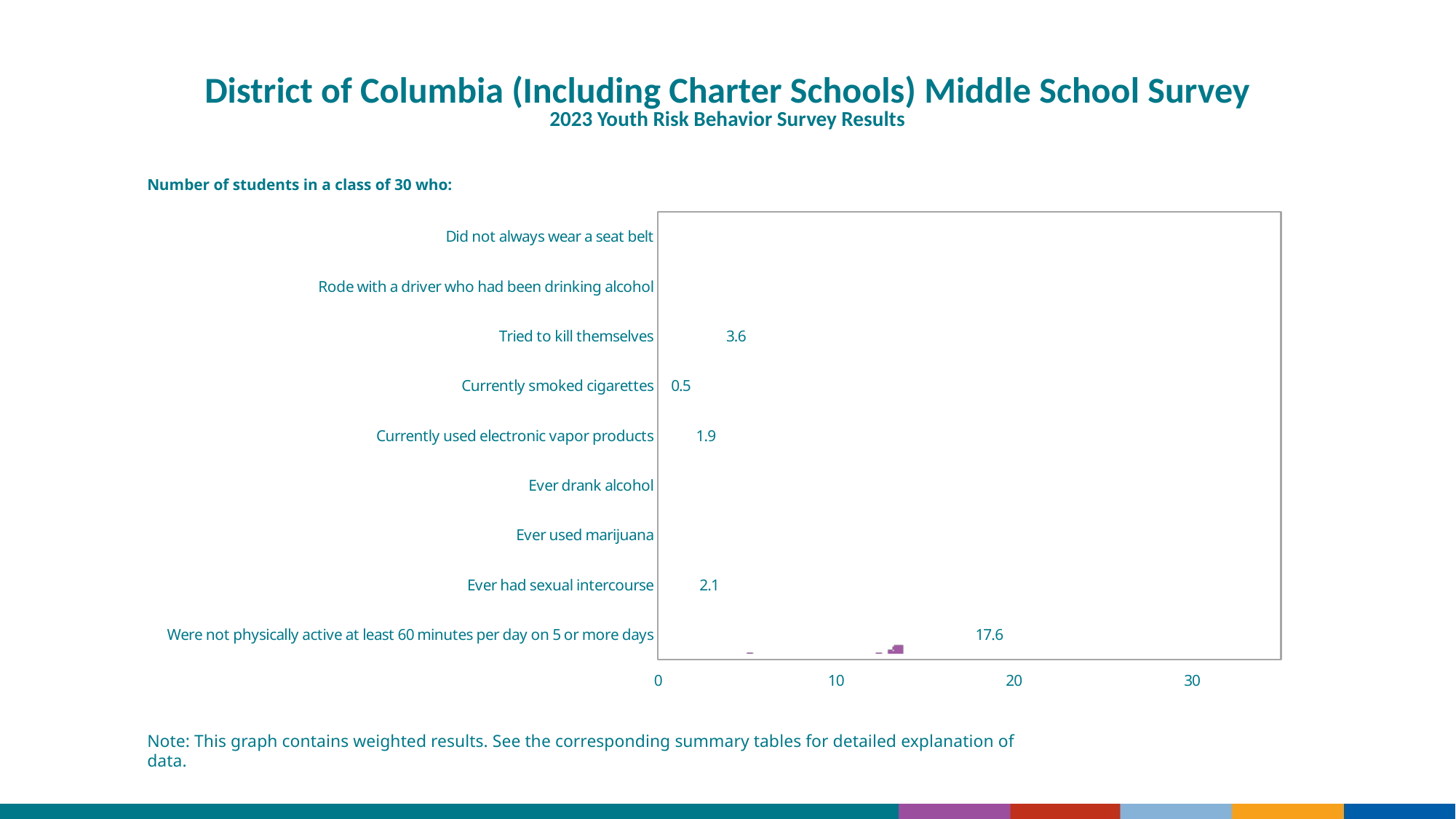
What is the difference between the values for 'Tried to kill themselves' and 'Ever had sexual intercourse'? 1.5 What is the difference between the values for 'Were not physically active at least 60 minutes per day on 5 or more days' and 'Tried to kill themselves'? 14.0 Among the values printed on the chart, which category has the highest value? Were not physically active at least 60 minutes per day on 5 or more days How many categories are listed on the chart's vertical axis? 9 Which is larger: the value for 'Currently used electronic vapor products' or the value for 'Currently smoked cigarettes'? Currently used electronic vapor products Among the values printed on the chart, which category has the lowest value? Currently smoked cigarettes What is the value for 'Ever had sexual intercourse'? 2.1 What is the value for 'Currently used electronic vapor products'? 1.9 What is the main title of the slide? District of Columbia (Including Charter Schools) Middle School Survey What is the value for 'Were not physically active at least 60 minutes per day on 5 or more days'? 17.6 What is the value for 'Currently smoked cigarettes'? 0.5 What is the value for 'Tried to kill themselves'? 3.6